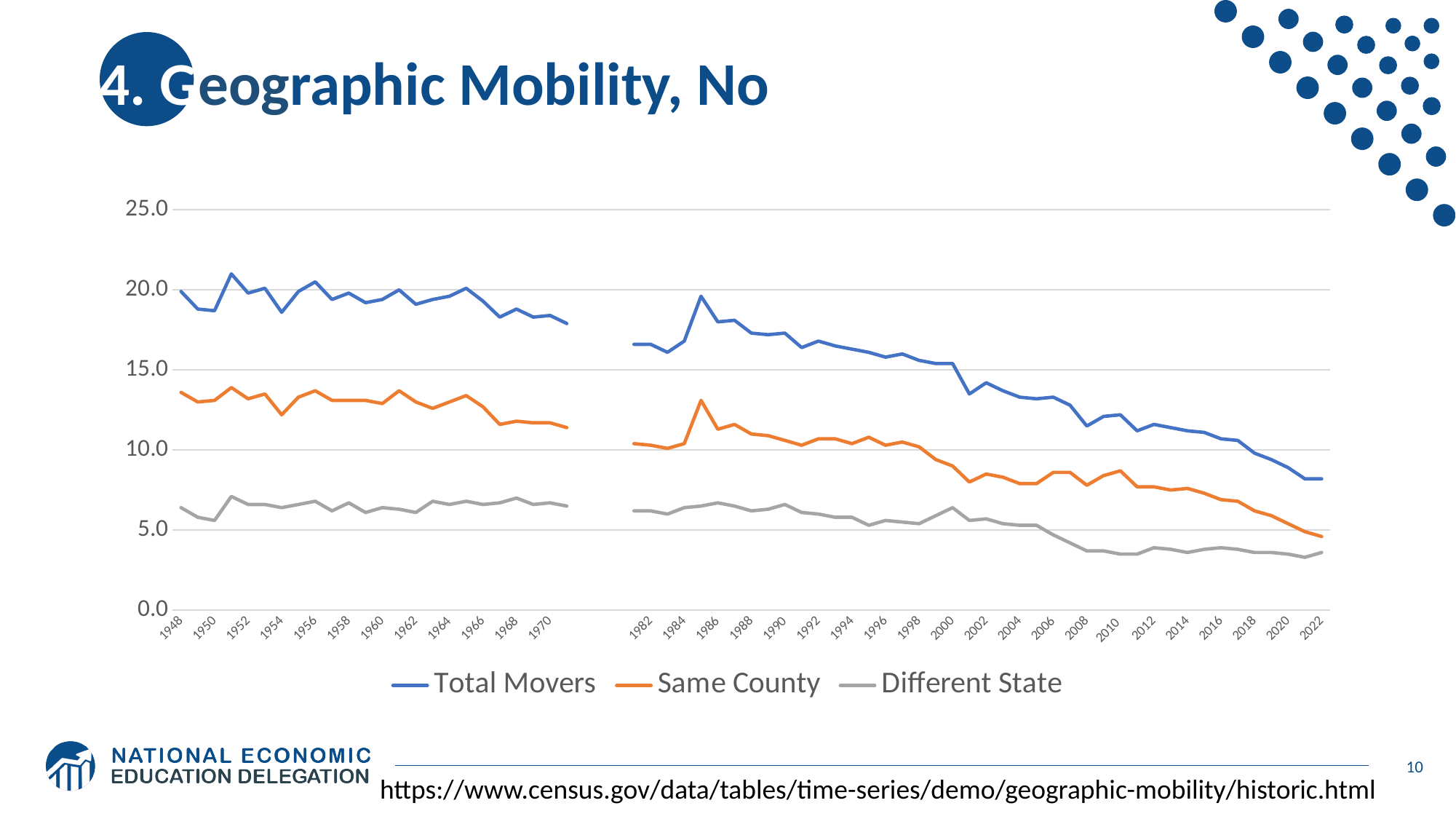
Is the value for Same County in 1948 greater or less than 10.0? greater Which series has the highest values across the whole chart? Total Movers What is the title of the slide containing the chart? 4. Geographic Mobility, No Do the values for Same County rise or fall from 2000 to 2022? Fall Which series has the lowest values across the whole chart? Different State How many series does the legend list? 3 Which is larger in 2022, Total Movers or Same County? Total Movers What kind of chart is shown on the slide? Line chart Is the value for Total Movers in 2022 greater or less than 10.0? less Do the values for Total Movers rise or fall from 1982 to 2022? Fall What colour is the Same County line? Orange Is the value for Different State in 2022 greater or less than 5.0? less